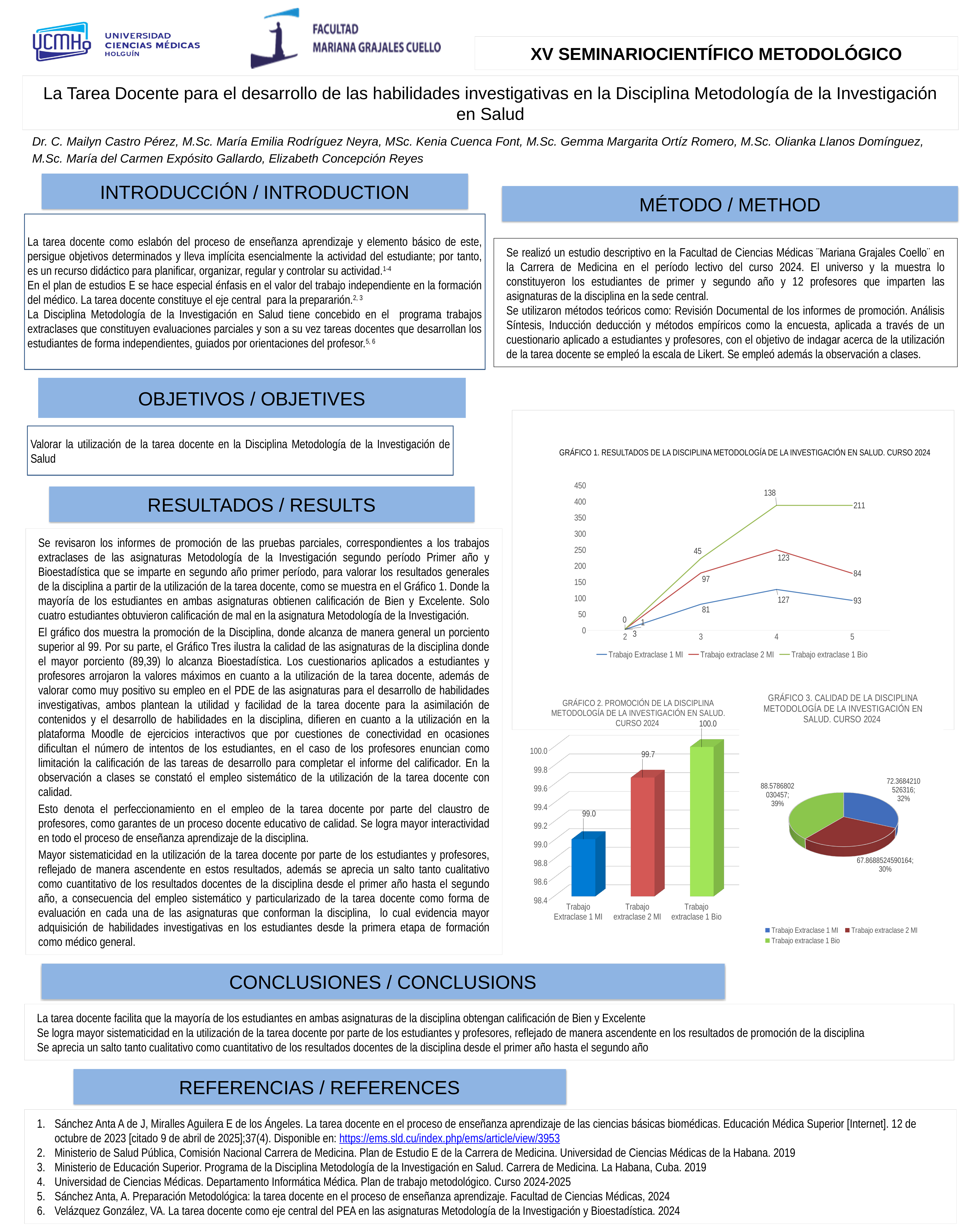
In Gráfico 2 (Promoción de la disciplina), which category has the lowest value? Trabajo Extraclase 1 MI In Gráfico 2 (Promoción de la disciplina), what is the value for Trabajo extraclase 2 MI? 99.7 In Gráfico 3 (Calidad de la disciplina), what percentage share does Trabajo extraclase 1 Bio have? 39% How many series does the legend of Gráfico 1 (Resultados de la disciplina) list? 3 What kind of chart is Gráfico 3 (Calidad de la disciplina)? Pie chart In Gráfico 2 (Promoción de la disciplina), what is the difference between the values for Trabajo extraclase 1 Bio and Trabajo Extraclase 1 MI? 1.0 What kind of chart is Gráfico 1 (Resultados de la disciplina)? Line chart In Gráfico 1 (Resultados de la disciplina), what is the data label for Trabajo extraclase 1 Bio at x = 5? 211 In Gráfico 1 (Resultados de la disciplina), what is the data label for Trabajo Extraclase 1 MI at x = 4? 127 What kind of chart is Gráfico 2 (Promoción de la disciplina)? Bar chart In Gráfico 3 (Calidad de la disciplina), which series has the smallest slice? Trabajo extraclase 2 MI In Gráfico 2 (Promoción de la disciplina), which category has the highest value? Trabajo extraclase 1 Bio